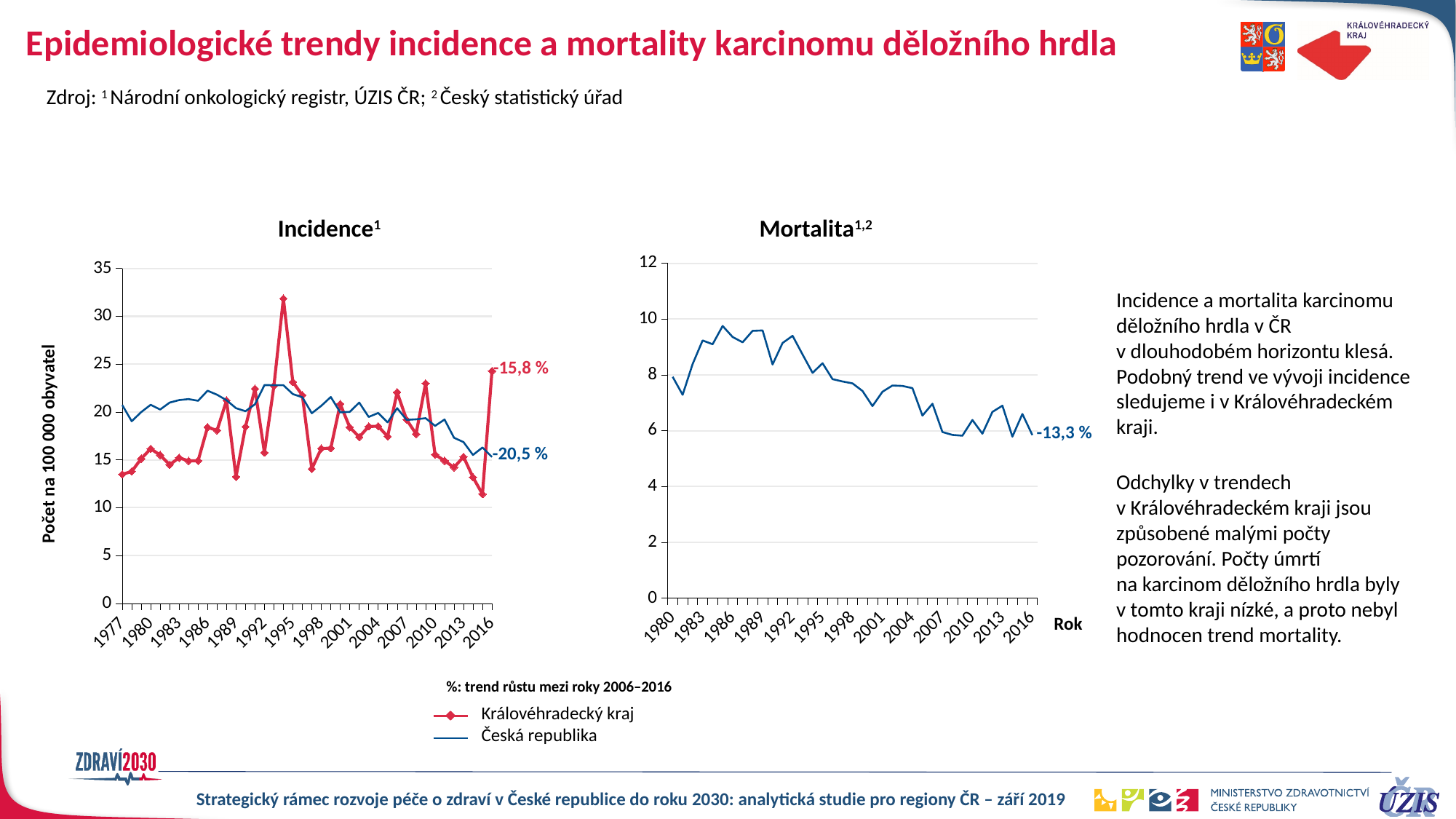
What is the highest value shown on the y axis of the Mortalita chart? 12 On the Mortalita chart, is the value in 2016 greater or less than 8? less On the Incidence chart, which series has the larger value in 1995, Královéhradecký kraj or Česká republika? Královéhradecký kraj On the Incidence chart, what growth trend between 2006 and 2016 is printed for Královéhradecký kraj? -15,8 % How many series does the legend list for the Incidence chart? 2 On the Incidence chart, is the value for Královéhradecký kraj in 1995 greater or less than 30? less On the Mortalita chart, do the values generally rise or fall from 1980 to 2016? fall On the Mortalita chart, what growth trend between 2006 and 2016 is printed? -13,3 % On the Incidence chart, what growth trend between 2006 and 2016 is printed for Česká republika? -20,5 % What kind of chart is the Incidence chart? line chart On the Incidence chart, in which year does the Královéhradecký kraj series reach its highest value? 1994 On the Incidence chart, is the value for Královéhradecký kraj in 2015 greater or less than 15? less